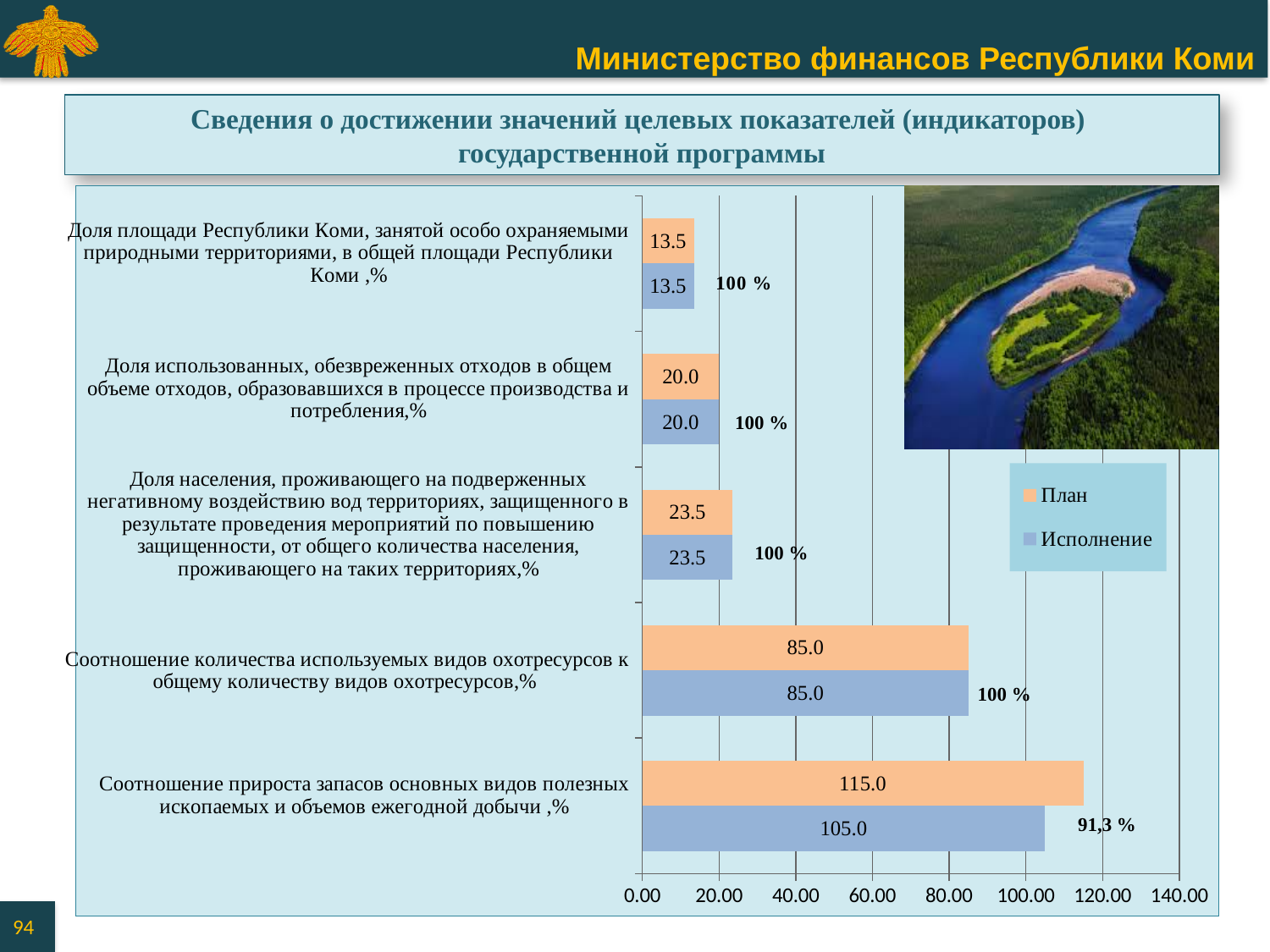
What percentage of achievement is shown next to the bars for "Соотношение прироста запасов основных видов полезных ископаемых и объемов ежегодной добычи ,%"? 91,3 % How many series does the legend list? 2 What kind of chart is shown on the slide? Bar chart How many categories are shown in the chart? 5 Which category has the lowest Исполнение value? Доля площади Республики Коми, занятой особо охраняемыми природными территориями, в общей площади Республики Коми ,% Which is larger for "Соотношение прироста запасов основных видов полезных ископаемых и объемов ежегодной добычи ,%": the План value or the Исполнение value? План What is the План value for "Доля использованных, обезвреженных отходов в общем объеме отходов, образовавшихся в процессе производства и потребления,%"? 20.0 What is the Исполнение value for "Соотношение прироста запасов основных видов полезных ископаемых и объемов ежегодной добычи ,%"? 105.0 What is the difference between the План and Исполнение values for "Соотношение прироста запасов основных видов полезных ископаемых и объемов ежегодной добычи ,%"? 10.0 What is the Исполнение value for "Соотношение количества используемых видов охотресурсов к общему количеству видов охотресурсов,%"? 85.0 What is the План value for "Соотношение прироста запасов основных видов полезных ископаемых и объемов ежегодной добычи ,%"? 115.0 Which category has the highest План value? Соотношение прироста запасов основных видов полезных ископаемых и объемов ежегодной добычи ,%